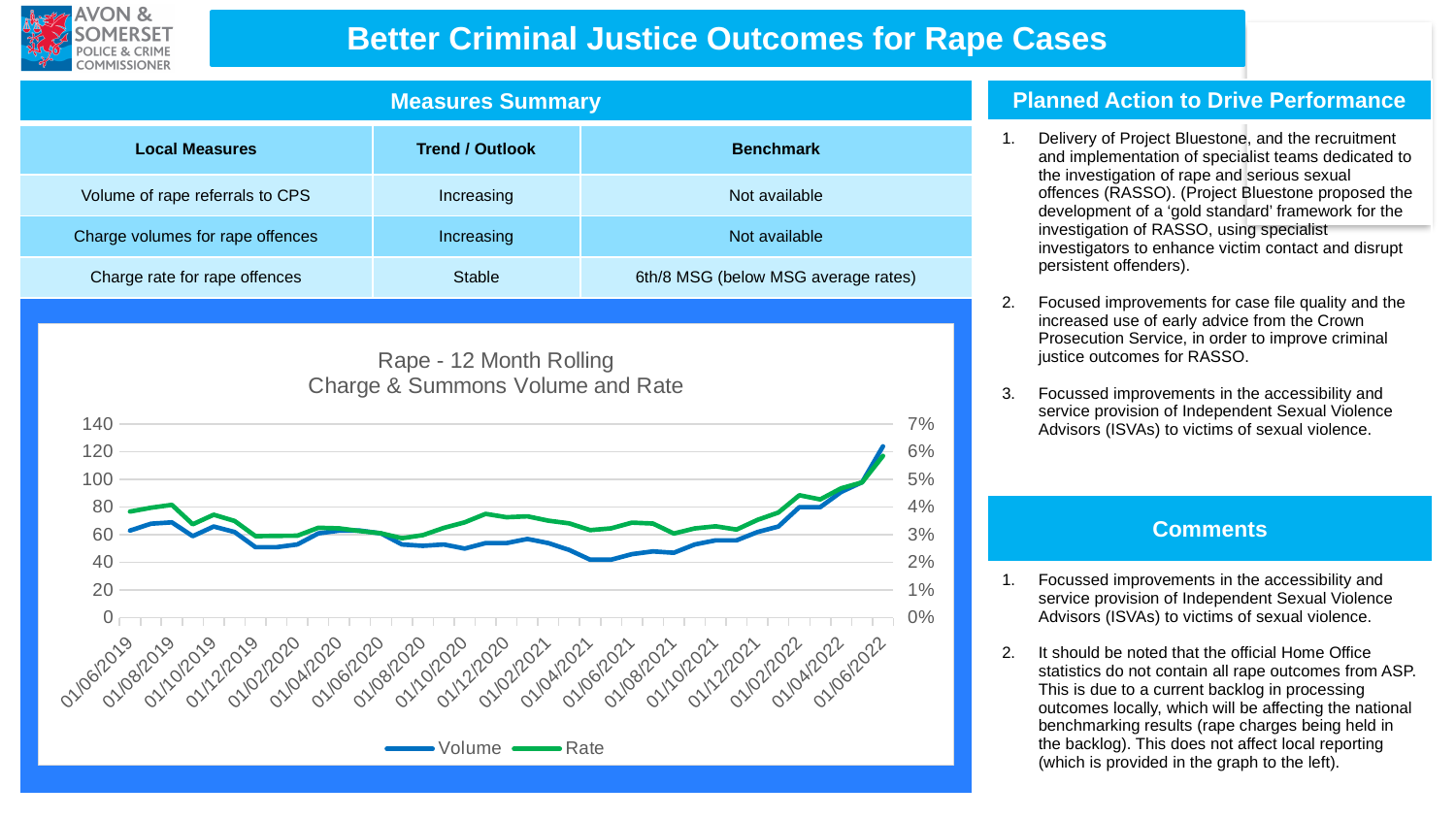
At which date does the Volume series reach its highest value? 01/06/2022 Is the Volume value at 01/06/2022 greater or less than 100? greater What kind of chart is shown on the slide? Line chart How many date labels are shown on the x axis? 19 How many series does the chart legend list? 2 Which is larger: the Volume value at 01/06/2022 or the Volume value at 01/06/2019? 01/06/2022 Is the Volume value at 01/04/2021 greater or less than 60? less Does the Volume series rise or fall between 01/04/2021 and 01/06/2022? Rise What are the two series named in the chart legend? Volume and Rate Is the Rate value at 01/06/2022 greater or less than 5%? greater What is the title of the chart? Rape - 12 Month Rolling Charge & Summons Volume and Rate